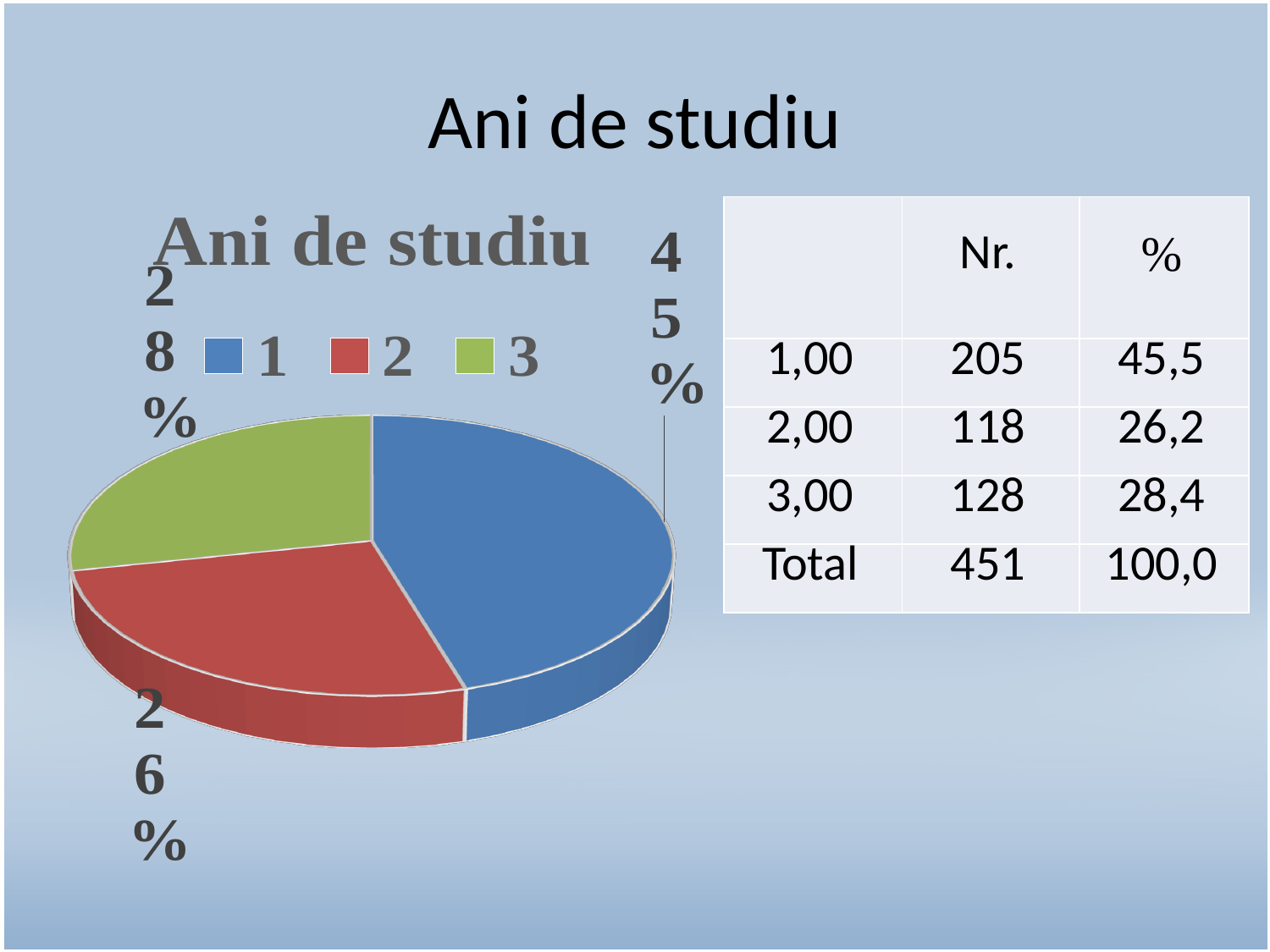
What is the title of the chart? Ani de studiu By how many percentage points does the slice for category 1 exceed the slice for category 2? 19 How many entries does the chart legend list? 3 What percentage is shown for category 3 in the pie chart? 28% Which category has the smallest slice of the pie chart? 2 Which category has the largest slice of the pie chart? 1 What percentage is shown for category 2 in the pie chart? 26% What colour is the slice for category 3 in the pie chart? green Which slice is larger in the pie chart, category 2 or category 3? 3 What kind of chart is shown on the slide? pie chart What percentage is shown for category 1 in the pie chart? 45% How many slices does the pie chart have? 3